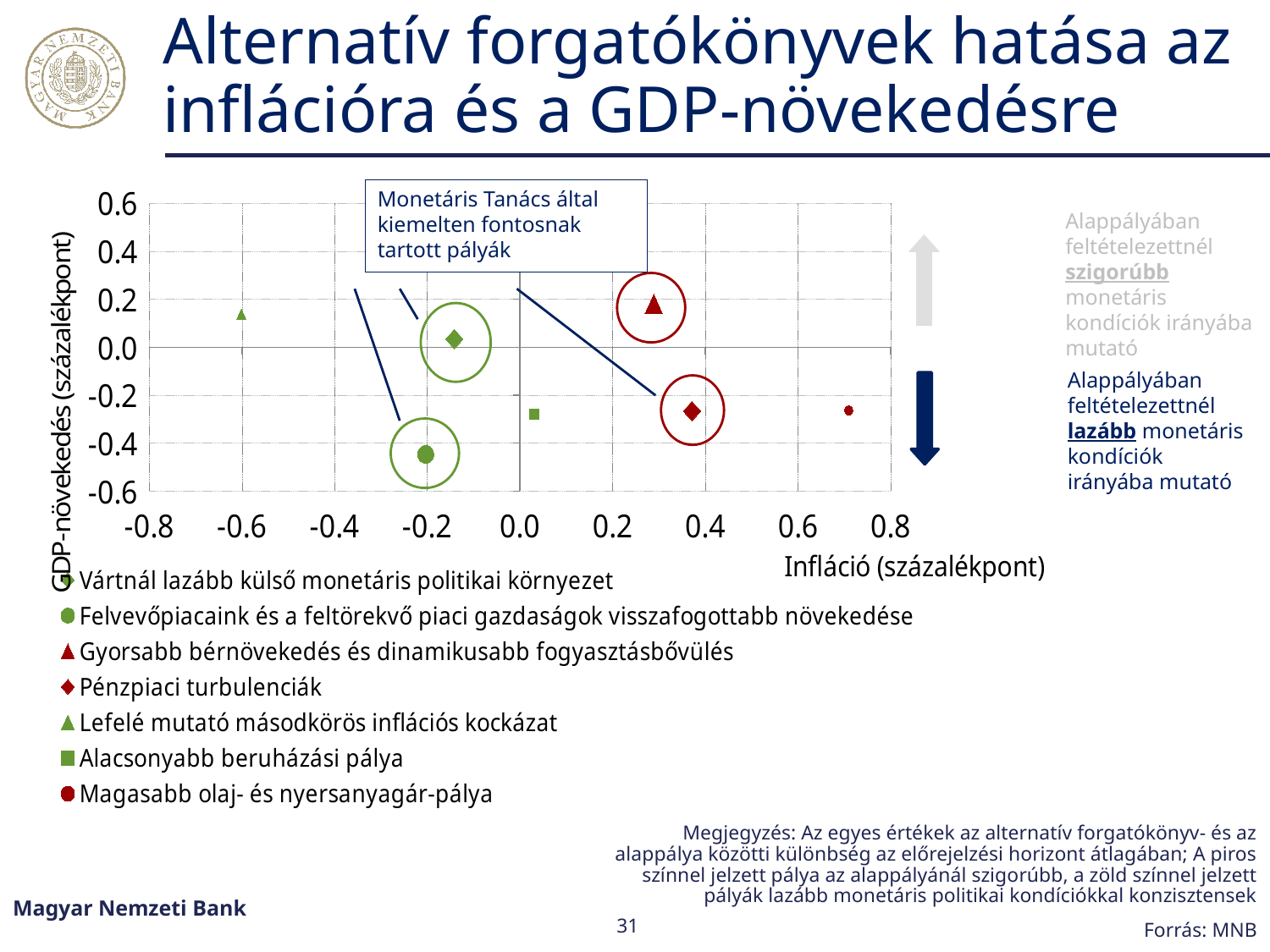
Which scenario has the higher GDP growth value: 'Gyorsabb bérnövekedés és dinamikusabb fogyasztásbővülés' or 'Pénzpiaci turbulenciák'? Gyorsabb bérnövekedés és dinamikusabb fogyasztásbővülés Is the inflation value for 'Magasabb olaj- és nyersanyagár-pálya' greater or less than 0.6? greater Which scenario has the highest inflation value in the chart? Magasabb olaj- és nyersanyagár-pálya How many series does the chart legend list? 7 What kind of chart is shown on the slide? Scatter chart Is the GDP growth value for 'Felvevőpiacaink és a feltörekvő piaci gazdaságok visszafogottabb növekedése' greater or less than -0.2? less What is the title of the horizontal axis of the chart? Infláció (százalékpont) Which scenario has the lowest GDP growth value in the chart? Felvevőpiacaink és a feltörekvő piaci gazdaságok visszafogottabb növekedése Is the inflation value for 'Pénzpiaci turbulenciák' greater or less than 0.2? greater Which scenario has the higher inflation value: 'Pénzpiaci turbulenciák' or 'Magasabb olaj- és nyersanyagár-pálya'? Magasabb olaj- és nyersanyagár-pálya Which scenario has the lowest inflation value in the chart? Lefelé mutató másodkörös inflációs kockázat What is the title of the vertical axis of the chart? GDP-növekedés (százalékpont)